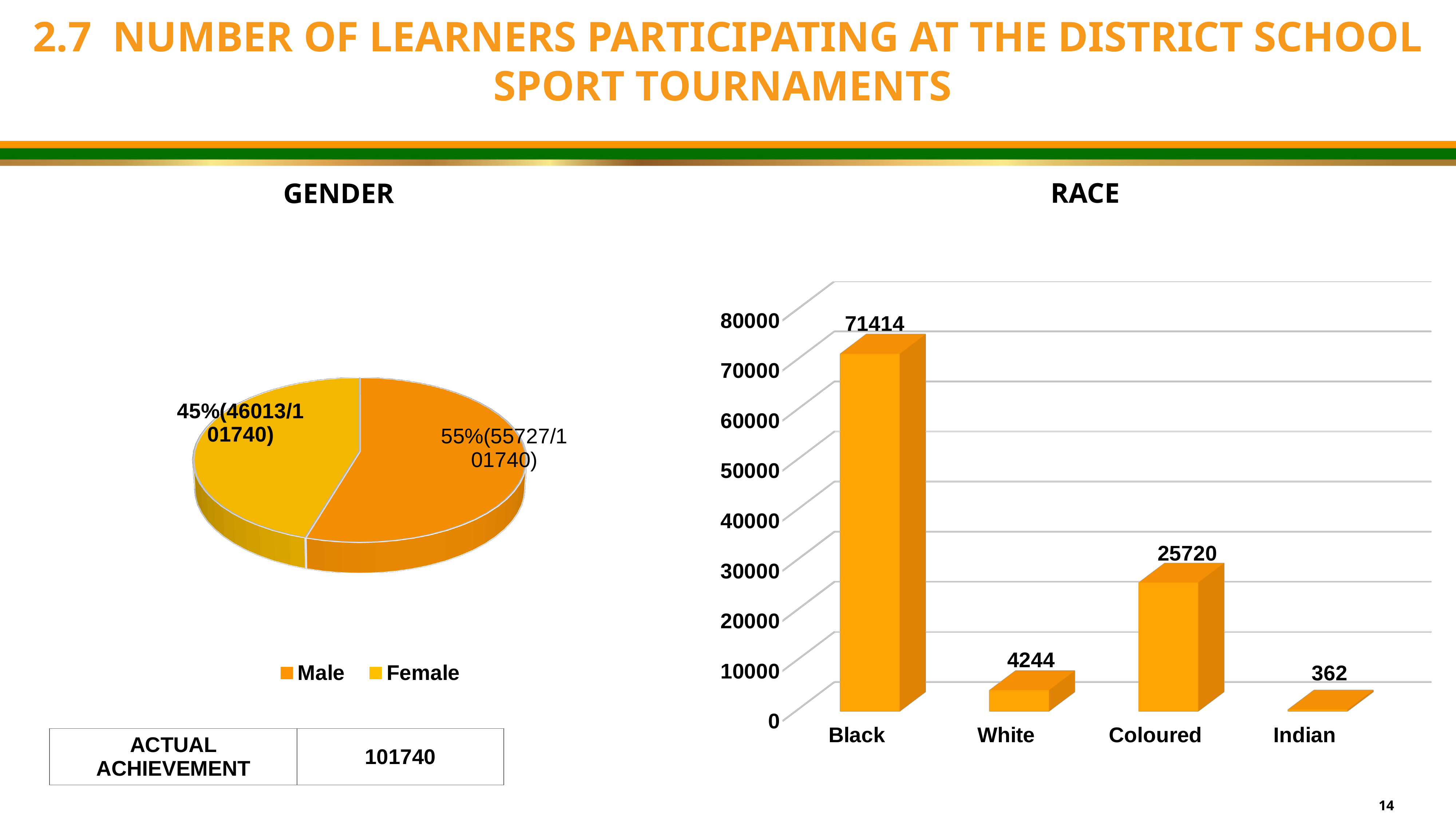
In the RACE chart, what is the difference between the values for Black and Coloured? 45694 In the RACE chart, what is the value for Coloured? 25720 In the GENDER chart, what share of the pie is Male? 55% How many entries does the legend of the GENDER chart list? 2 In the RACE chart, which category has the lowest value? Indian In the GENDER chart, what share of the pie is Female? 45% How many categories are shown in the RACE chart? 4 In the RACE chart, which is larger, the value for White or the value for Coloured? Coloured In the RACE chart, which category has the highest value? Black What kind of chart is the RACE chart? Bar chart In the RACE chart, what is the value for Black? 71414 In the RACE chart, what is the value for Indian? 362